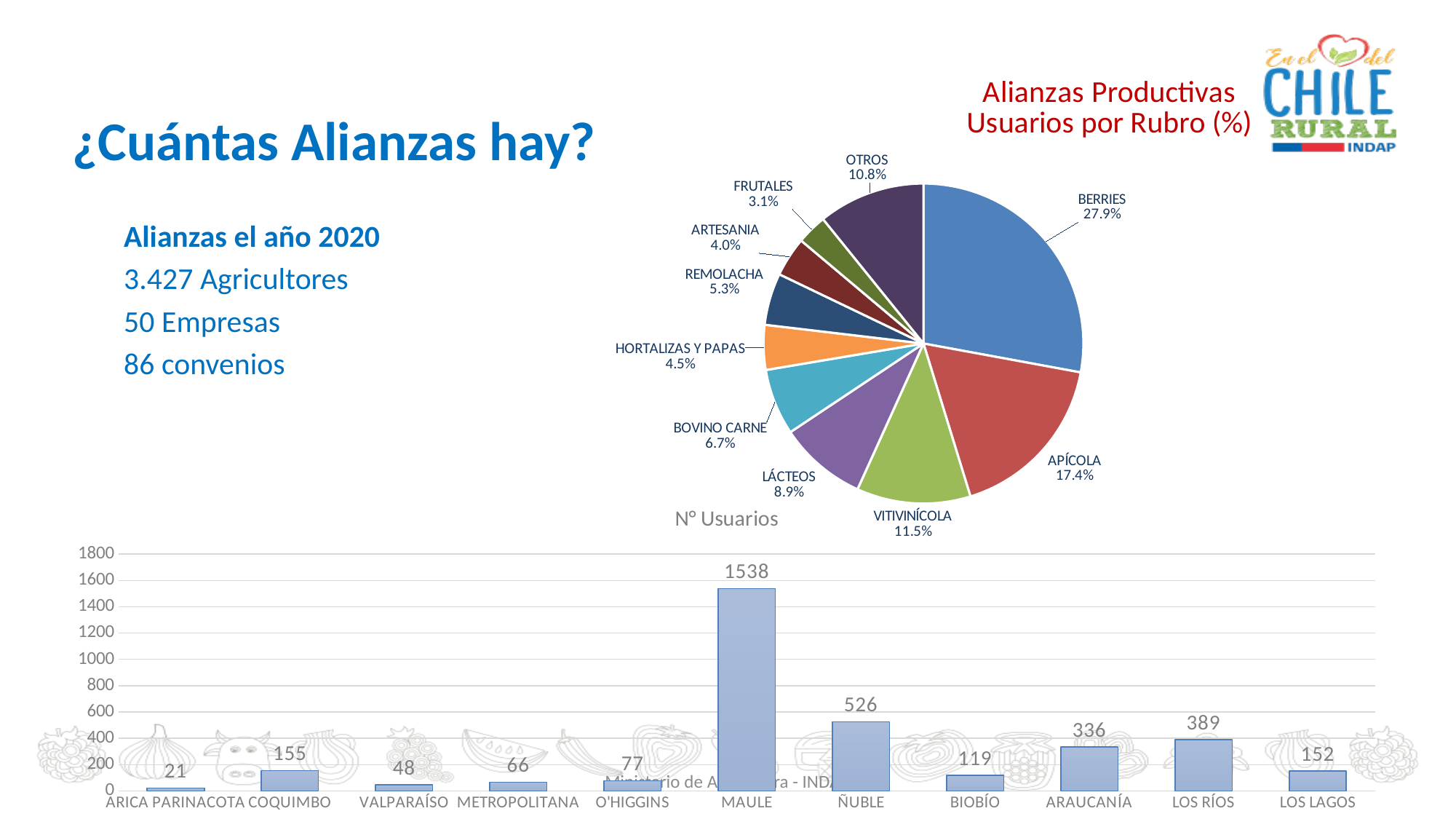
In the bar chart 'N° Usuarios', how many regions are shown? 11 In the pie chart 'Alianzas Productivas Usuarios por Rubro (%)', what share does BERRIES have? 27.9% What type of chart is the 'N° Usuarios' chart at the bottom of the slide? Bar chart In the pie chart 'Alianzas Productivas Usuarios por Rubro (%)', how many slices are there? 10 In the bar chart 'N° Usuarios', what is the value for ARAUCANÍA? 336 In the bar chart 'N° Usuarios', which region has the lowest value? ARICA PARINACOTA In the bar chart 'N° Usuarios', which is larger, LOS RÍOS or ÑUBLE? ÑUBLE In the pie chart 'Alianzas Productivas Usuarios por Rubro (%)', what is the difference between the shares of APÍCOLA and VITIVINÍCOLA? 5.9% In the bar chart 'N° Usuarios', what is the value for MAULE? 1538 In the pie chart 'Alianzas Productivas Usuarios por Rubro (%)', what share does LÁCTEOS have? 8.9% In the pie chart 'Alianzas Productivas Usuarios por Rubro (%)', which rubro has the smallest share? FRUTALES In the pie chart 'Alianzas Productivas Usuarios por Rubro (%)', which rubro has the largest share? BERRIES